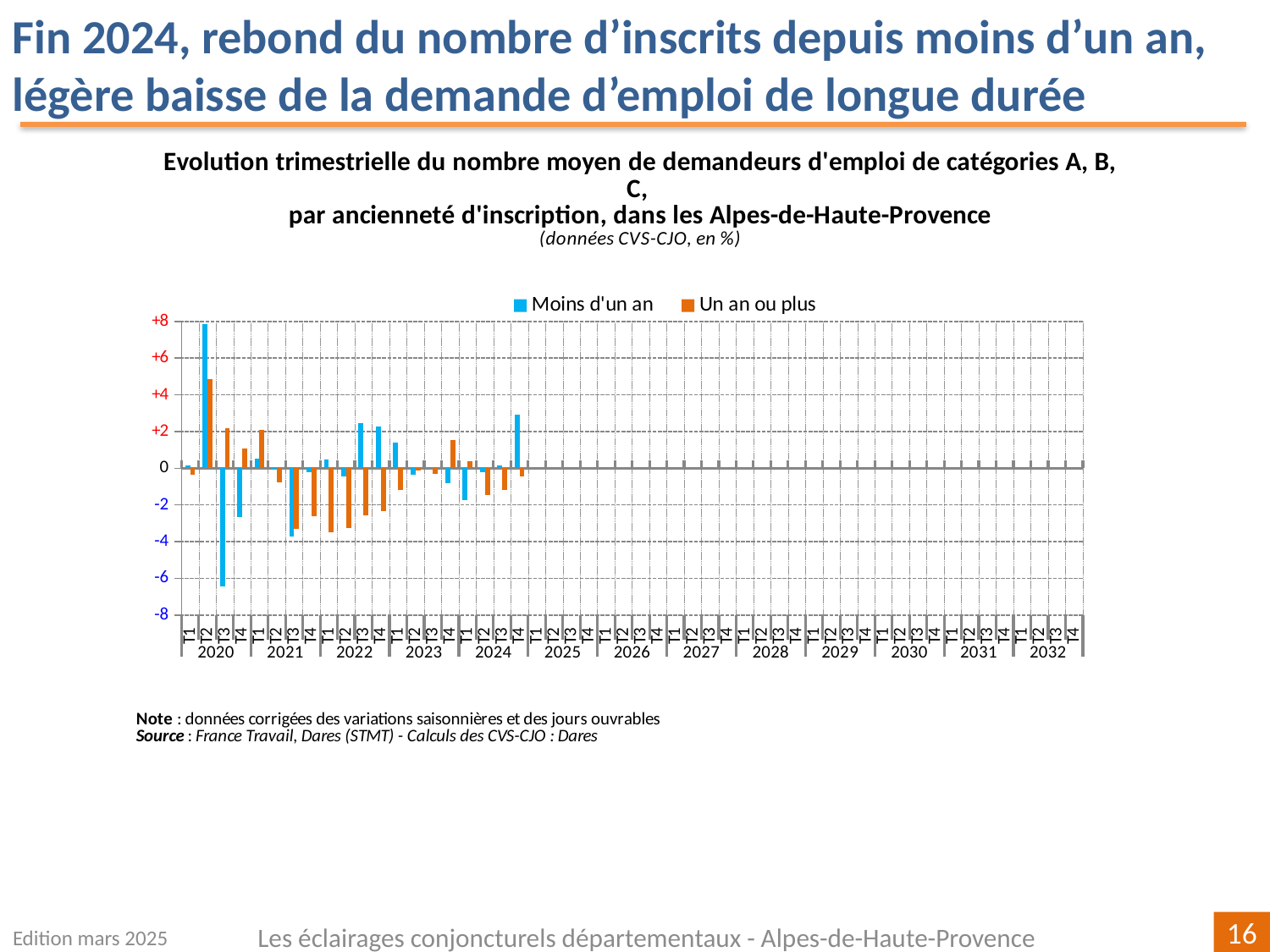
Is the value for "Un an ou plus" in T2 2020 greater or less than +4? greater Is the value for "Moins d'un an" in T2 2020 greater or less than +6? greater How many series does the legend list? 2 In which quarter does the series "Moins d'un an" reach its lowest value? T3 2020 Is the value for "Moins d'un an" in T3 2020 greater or less than -4? less In which quarter does the series "Un an ou plus" reach its highest value? T2 2020 In T4 2024, which series has the larger value, "Moins d'un an" or "Un an ou plus"? Moins d'un an In which quarter does the series "Moins d'un an" reach its highest value? T2 2020 What kind of chart is shown on the slide? Bar chart What are the two series named in the legend? Moins d'un an; Un an ou plus Which colour represents the series "Un an ou plus"? Orange